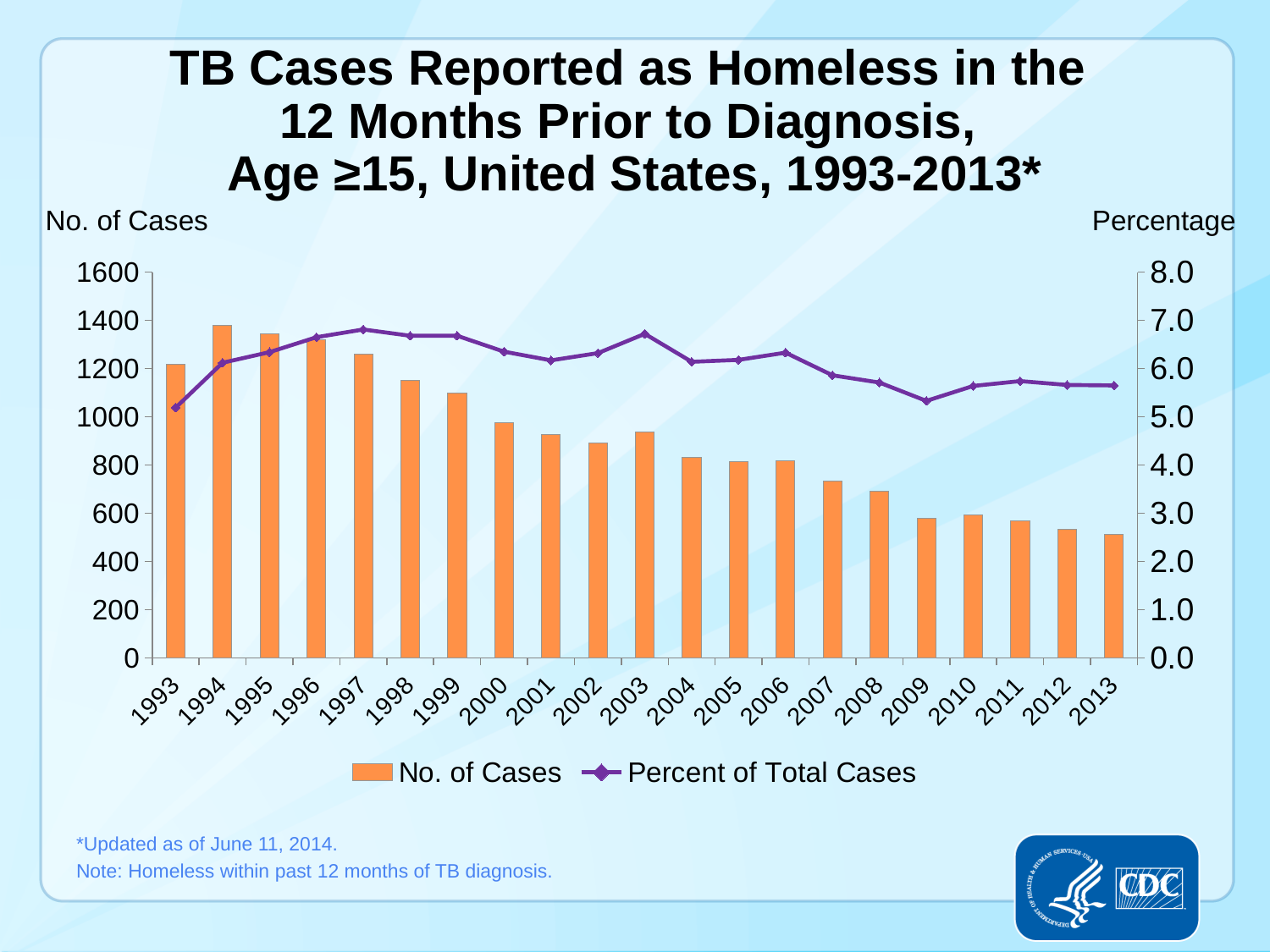
What is the label of the right-hand vertical axis? Percentage Is the percent of total cases for 1993 greater or less than 6.0? less Which year has the highest number of cases? 1994 Is the number of cases for 2013 greater or less than 600? less Overall, does the number of cases rise or fall from 1993 to 2013? Fall How many series does the legend list? 2 Is the number of cases for 2008 greater or less than 800? less How many years are shown on the x axis? 21 What kind of chart is shown on the slide? A combined bar and line chart Which year has more cases, 1994 or 2013? 1994